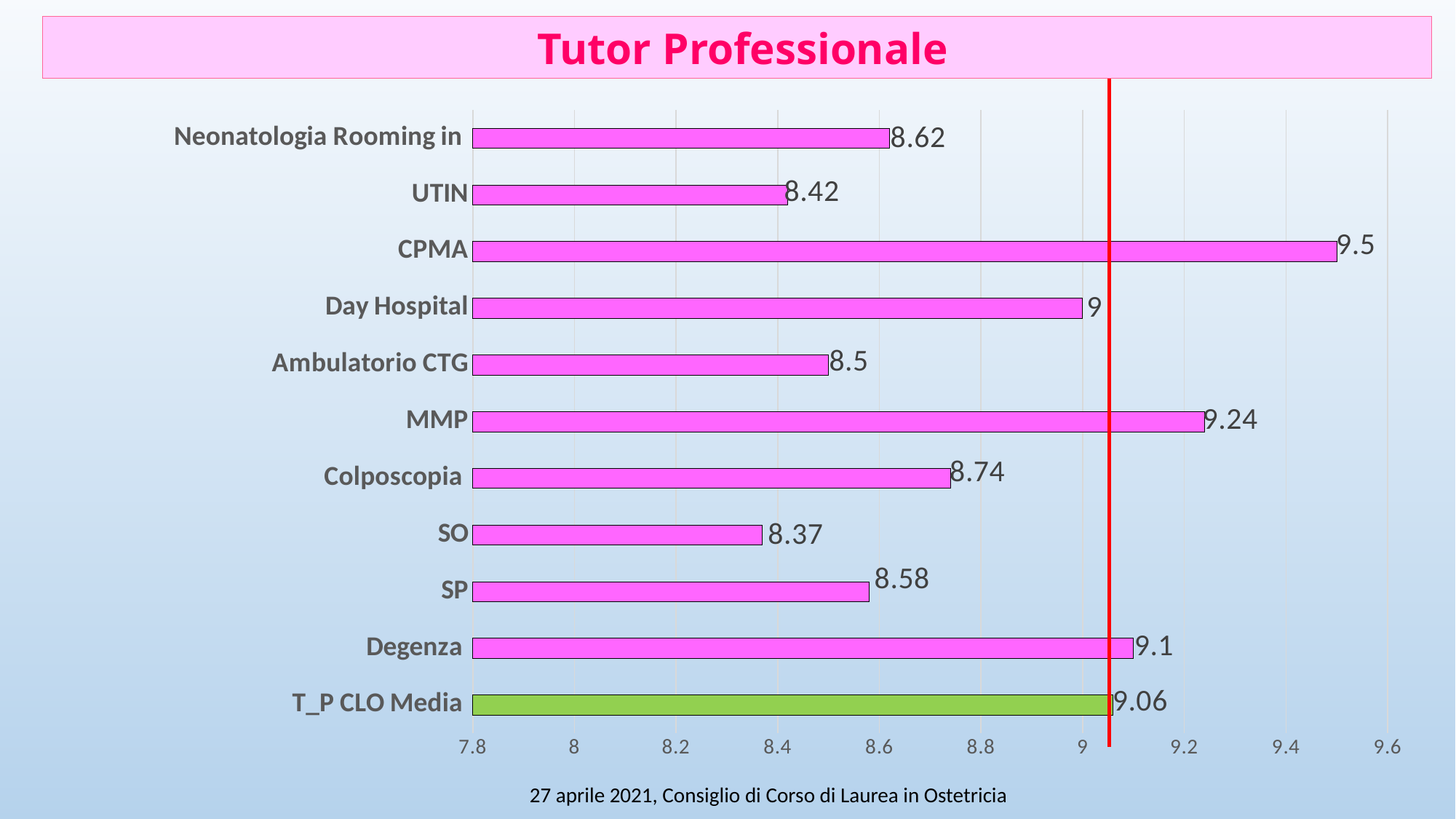
Which category's bar is coloured green instead of pink? T_P CLO Media Which category has the lowest value? SO What is the difference between the values for CPMA and UTIN? 1.08 Which is larger, the value for MMP or the value for Degenza? MMP How many categories are shown in the chart? 11 What is the value for T_P CLO Media? 9.06 What is the value for CPMA? 9.5 Is the value for Day Hospital greater or less than 8.8? greater Which category has the highest value? CPMA What is the title of the chart? Tutor Professionale What is the value for Colposcopia? 8.74 What kind of chart is shown on the slide? Bar chart